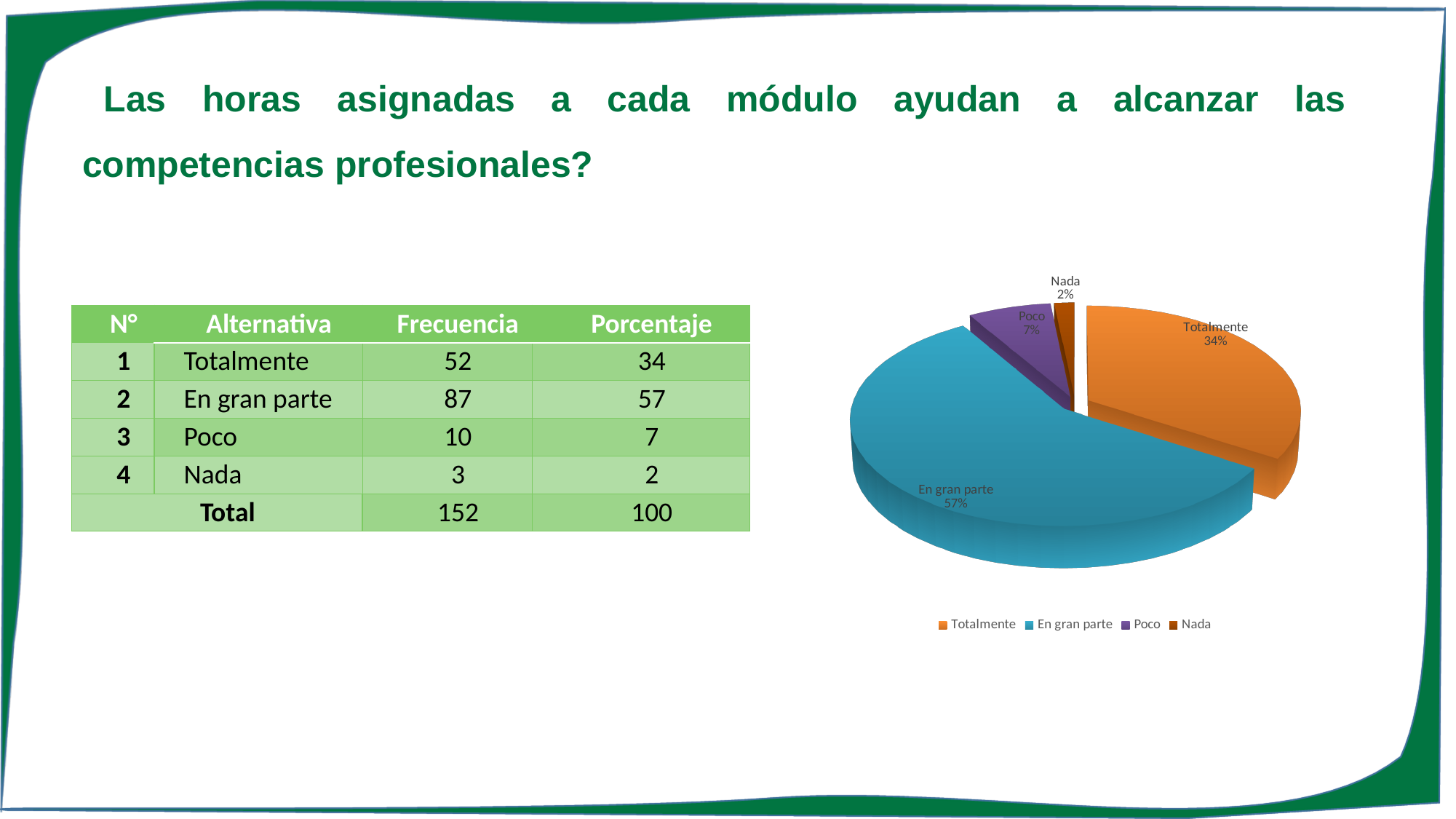
What is the difference in percentage points between En gran parte and Totalmente in the pie chart? 23 What kind of chart is shown on the slide? pie chart Which slice is larger in the pie chart, Poco or Nada? Poco What colour is the En gran parte slice in the pie chart? blue What percentage does the pie chart show for Nada? 2% How many entries does the pie chart legend list? 4 What percentage does the pie chart show for Totalmente? 34% Which category has the largest slice in the pie chart? En gran parte How many slices does the pie chart have? 4 What percentage does the pie chart show for En gran parte? 57% Which category has the smallest slice in the pie chart? Nada What percentage does the pie chart show for Poco? 7%